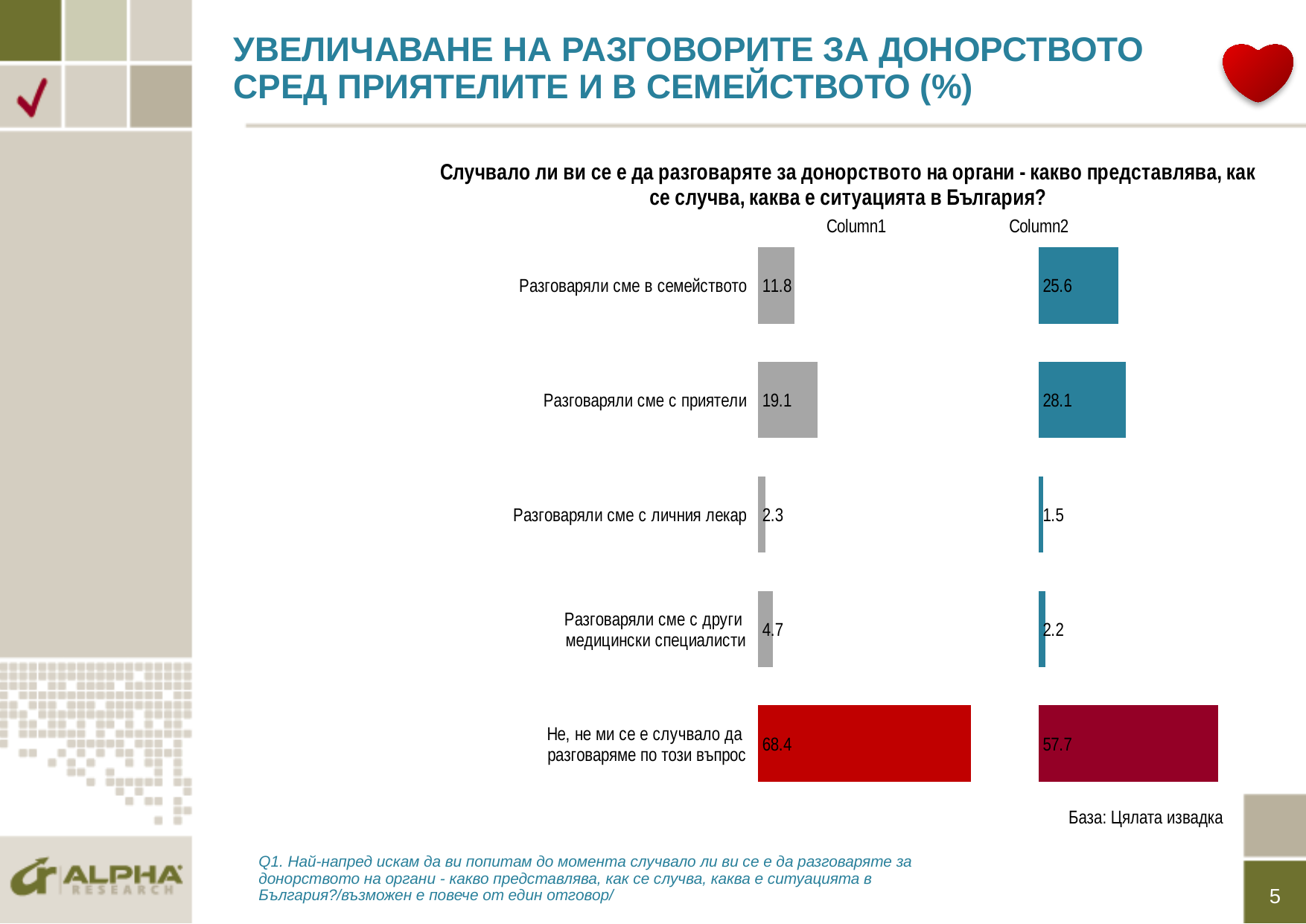
Which category has the lowest Column2 value? Разговаряли сме с личния лекар What are the names of the two series shown above the bars? Column1 and Column2 What is the Column1 value for "Разговаряли сме в семейството"? 11.8 How many categories are shown in the chart? 5 Which is larger for "Разговаряли сме с други медицински специалисти": the Column1 value or the Column2 value? Column1 What is the Column2 value for "Разговаряли сме с личния лекар"? 1.5 What is the difference between the Column1 and Column2 values for "Не, не ми се е случвало да разговаряме по този въпрос"? 10.7 How many series does the chart show? 2 What is the difference between the Column1 and Column2 values for "Разговаряли сме в семейството"? 13.8 What is the Column2 value for "Разговаряли сме с приятели"? 28.1 What kind of chart is shown on the slide? Bar chart Which category has the highest Column1 value? Не, не ми се е случвало да разговаряме по този въпрос